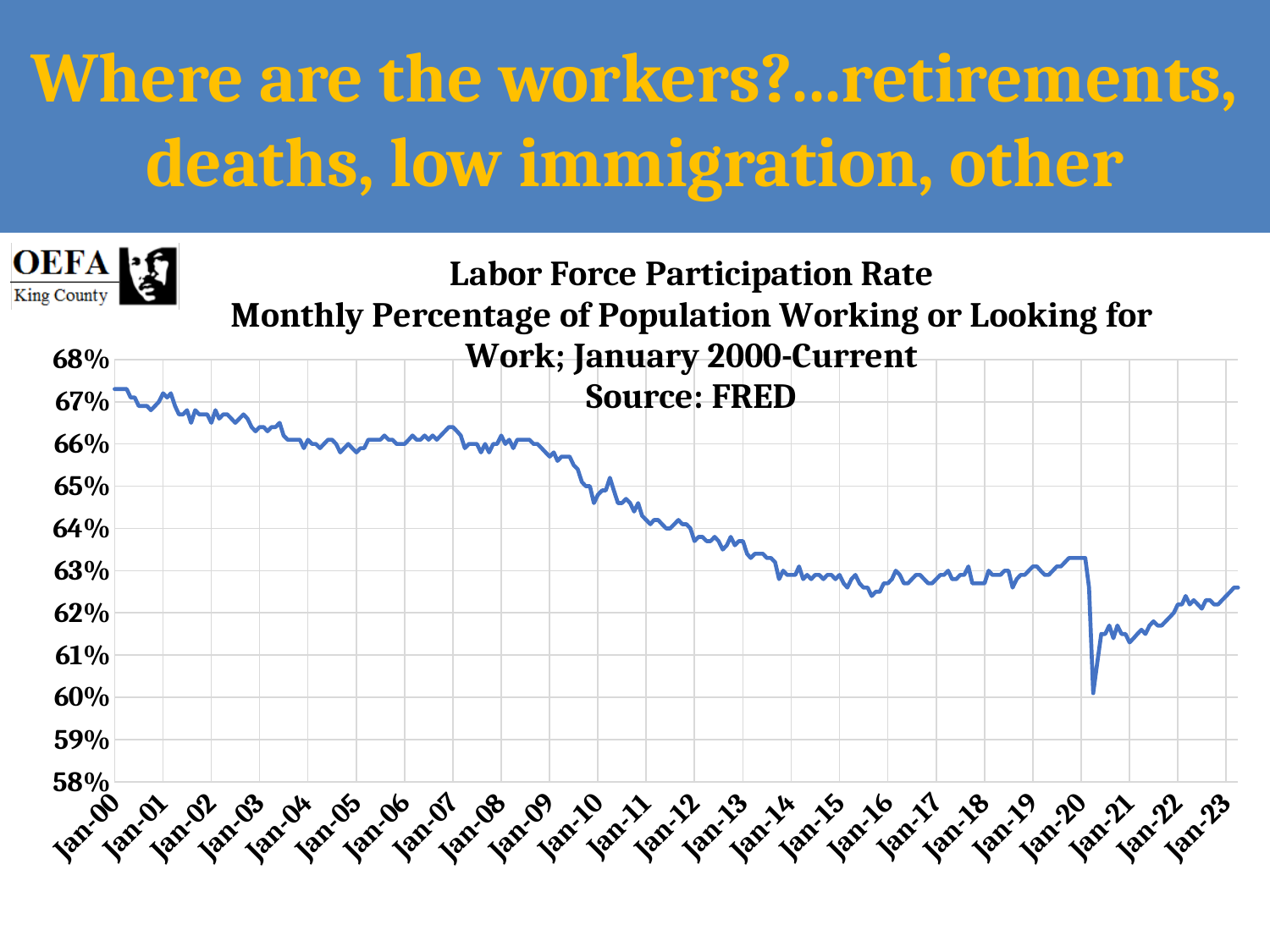
Is the lowest point on the line, in 2020, greater or less than 61%? less What kind of chart is shown on the slide? line chart How many year labels are shown on the x axis? 24 Which is larger, the value at Jan-05 or the value at Jan-15? Jan-05 Is the value at Jan-05 greater or less than 65%? greater Overall, does the labor force participation rate rise or fall from Jan-00 to Jan-23? fall What is the title of the chart? Labor Force Participation Rate Is the value at Jan-10 greater or less than 66%? less Which is larger, the value at Jan-00 or the value at Jan-23? Jan-00 What source is cited for the chart's data? FRED